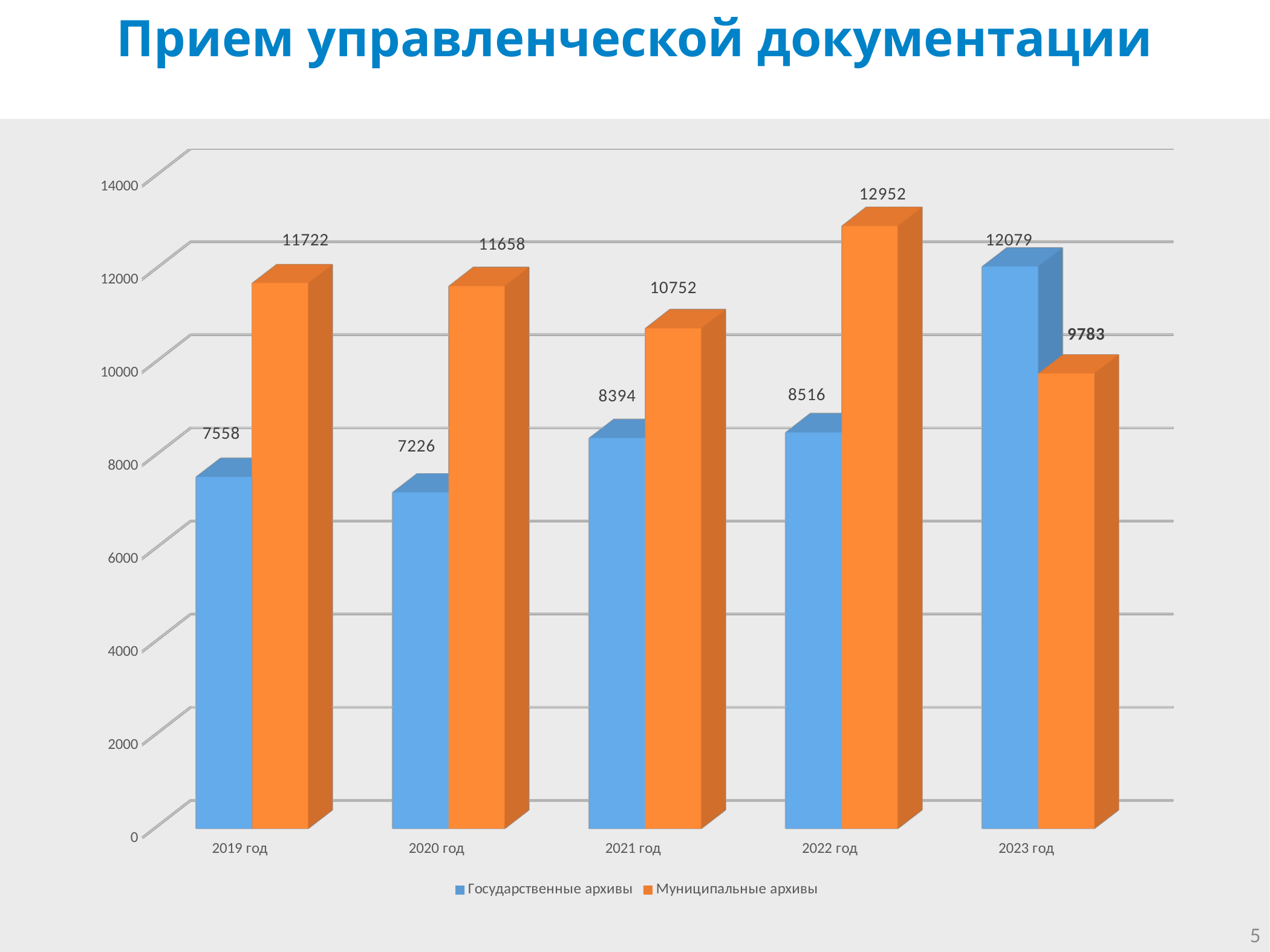
What is the value for Государственные архивы in 2019 год? 7558 What is the value for Муниципальные архивы in 2023 год? 9783 How many years are shown on the x axis? 5 What is the title of the slide? Прием управленческой документации What kind of chart is shown on the slide? bar chart How many series does the legend list? 2 Which is larger in 2023 год: Государственные архивы or Муниципальные архивы? Государственные архивы What is the value for Муниципальные архивы in 2022 год? 12952 Is the value for Государственные архивы in 2020 год greater or less than 8000? less What is the difference between Муниципальные архивы and Государственные архивы in 2021 год? 2358 In which year is the value for Муниципальные архивы lowest? 2023 год In which year is the value for Государственные архивы highest? 2023 год